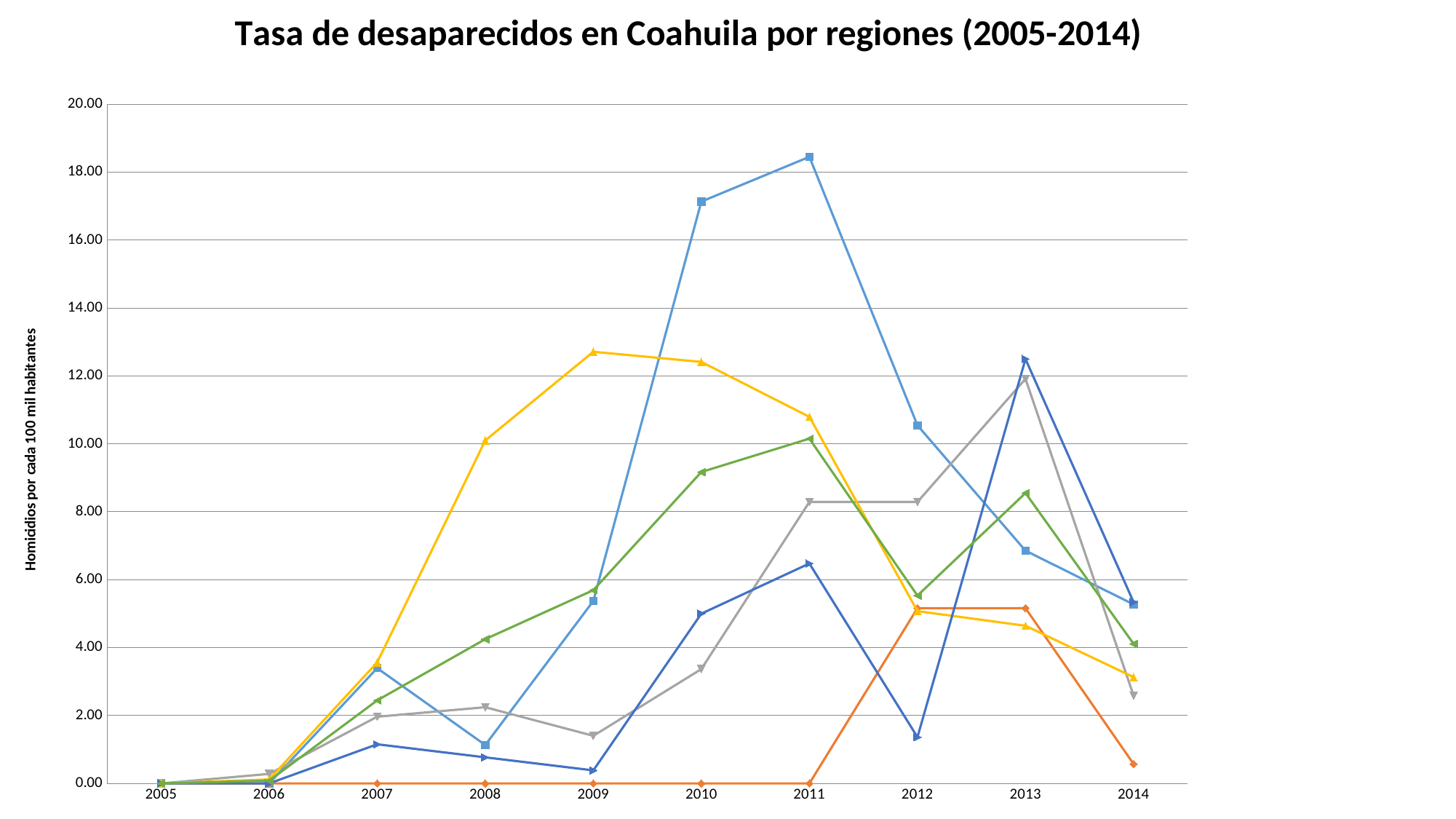
In which year does the light blue line reach its highest value? 2011 Is the value of the dark blue line in 2012 greater or less than 2.00? less Is the value of the gray line in 2013 greater or less than 10.00? greater What is the label on the vertical axis of the chart? Homicidios por cada 100 mil habitantes In 2010, which line has the higher value: the light blue line or the yellow line? the light blue line Does the light blue line rise or fall from 2011 to 2014? fall Is the value of the light blue line in 2010 greater or less than 16.00? greater What kind of chart is shown on the slide? line chart What is the title of the chart? Tasa de desaparecidos en Coahuila por regiones (2005-2014) How many years are shown along the x axis of the chart? 10